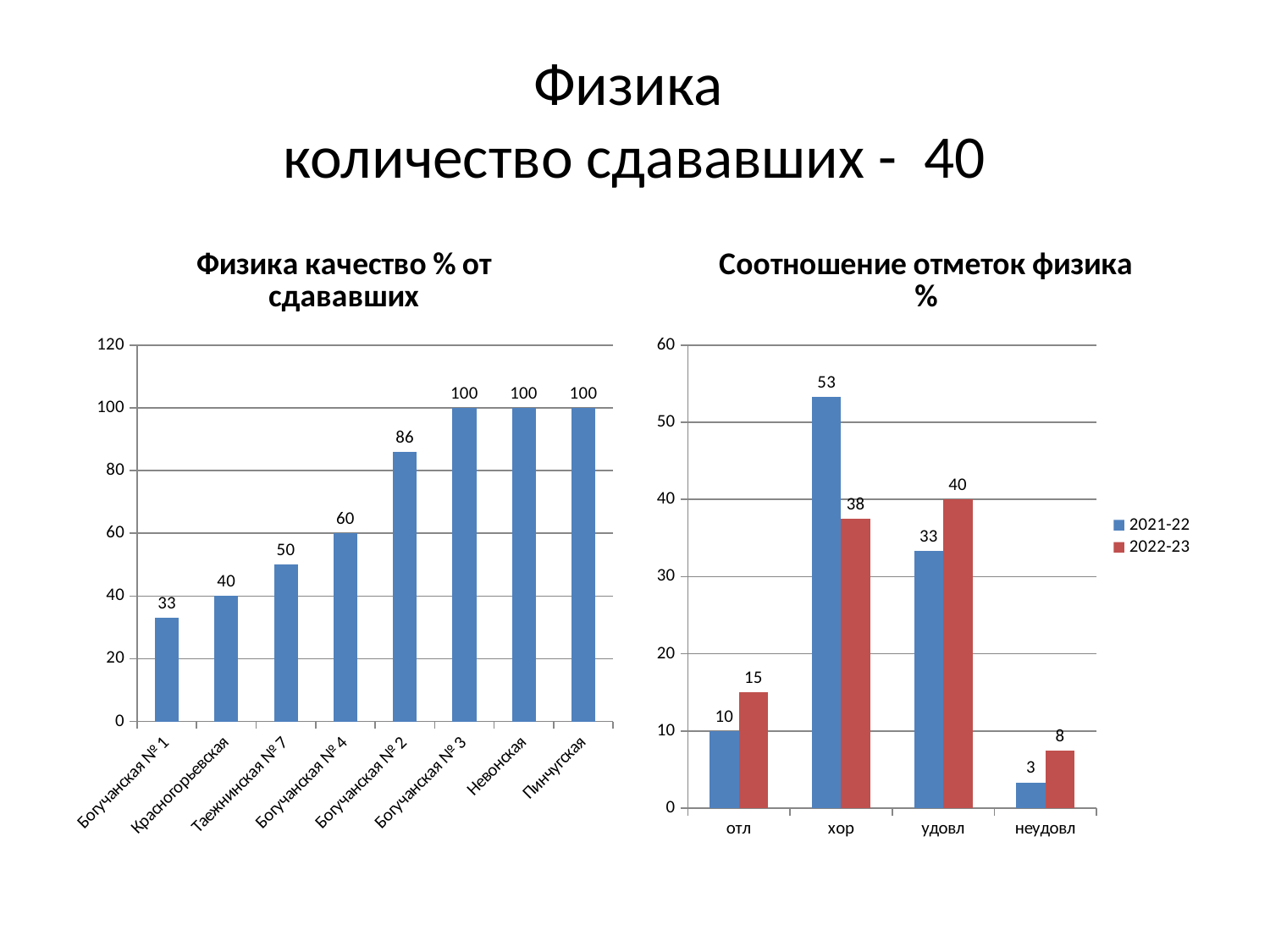
In the right chart 'Соотношение отметок физика %', what is the value for неудовл in 2022-23? 8 In the left chart 'Физика качество % от сдававших', what is the difference between the values for Богучанская № 4 and Красногорьевская? 20 In the left chart 'Физика качество % от сдававших', how many categories are shown on the x axis? 8 In the right chart 'Соотношение отметок физика %', how many series does the legend list? 2 In the right chart 'Соотношение отметок физика %', which is larger for удовл: 2021-22 or 2022-23? 2022-23 In the left chart 'Физика качество % от сдававших', do the values rise or fall from left to right along the x axis? rise In the left chart 'Физика качество % от сдававших', what is the value for Богучанская № 2? 86 In the right chart 'Соотношение отметок физика %', what is the difference between the 2021-22 and 2022-23 values for хор? 15 In the left chart 'Физика качество % от сдававших', which category has the lowest value? Богучанская № 1 In the left chart 'Физика качество % от сдававших', what is the value for Богучанская № 1? 33 What kind of chart is the right chart 'Соотношение отметок физика %'? bar chart In the right chart 'Соотношение отметок физика %', what is the value for хор in 2021-22? 53